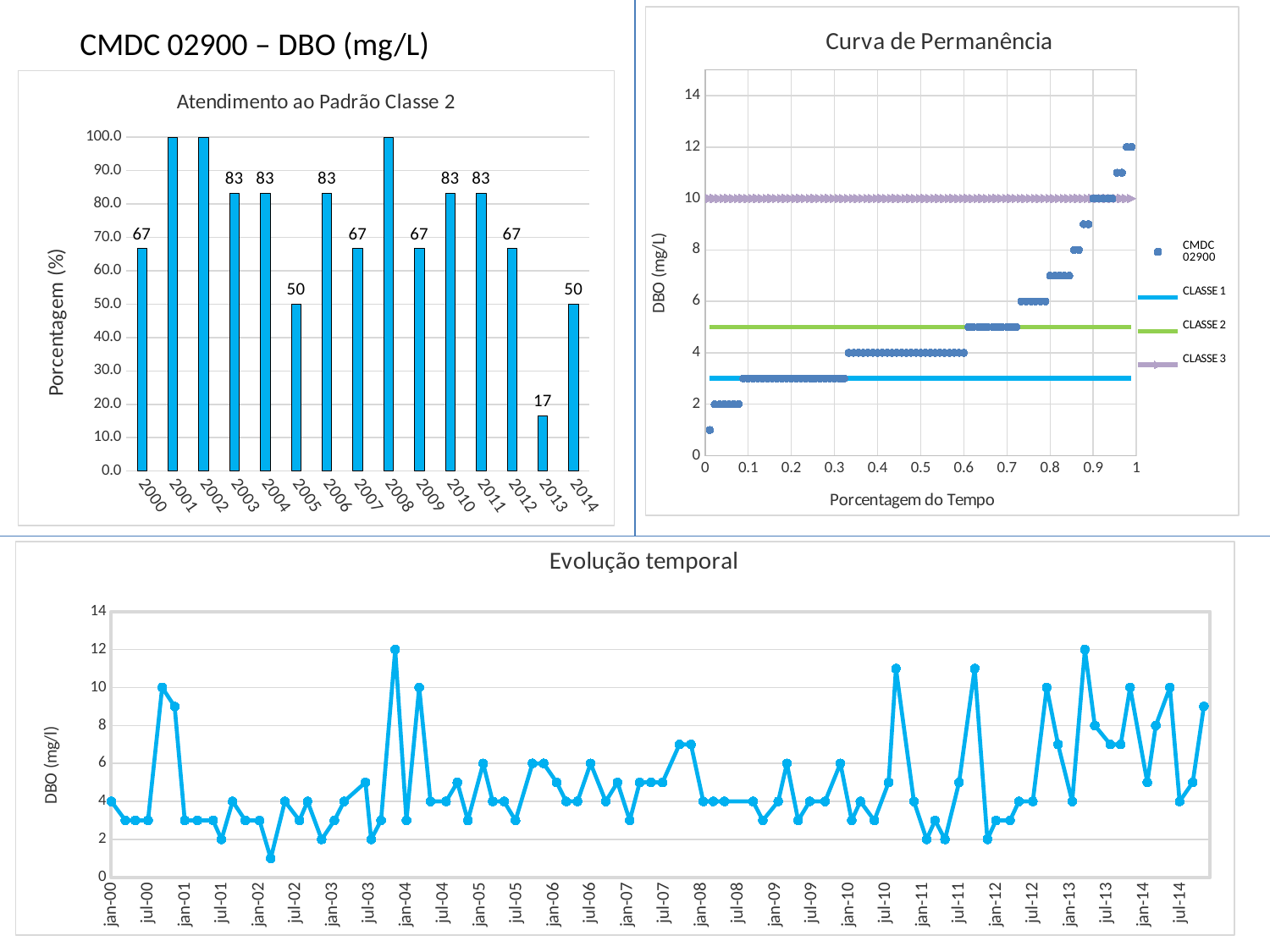
In the 'Atendimento ao Padrão Classe 2' chart, what is the difference between the values for 2003 and 2013? 66 What kind of chart is 'Atendimento ao Padrão Classe 2'? bar chart In the 'Atendimento ao Padrão Classe 2' chart, which year has the larger value, 2006 or 2007? 2006 What is the x-axis title of the 'Curva de Permanência' chart? Porcentagem do Tempo What kind of chart is 'Evolução temporal'? line chart In the 'Atendimento ao Padrão Classe 2' chart, which year has the lowest value? 2013 How many series does the legend of the 'Curva de Permanência' chart list? 4 In the 'Atendimento ao Padrão Classe 2' chart, what is the value for 2013? 17 In the 'Atendimento ao Padrão Classe 2' chart, how many years (bars) are shown? 15 In the 'Atendimento ao Padrão Classe 2' chart, is the value for 2001 greater or less than 90? greater What is the y-axis label of the 'Evolução temporal' chart? DBO (mg/l) In the 'Atendimento ao Padrão Classe 2' chart, what is the value for 2005? 50